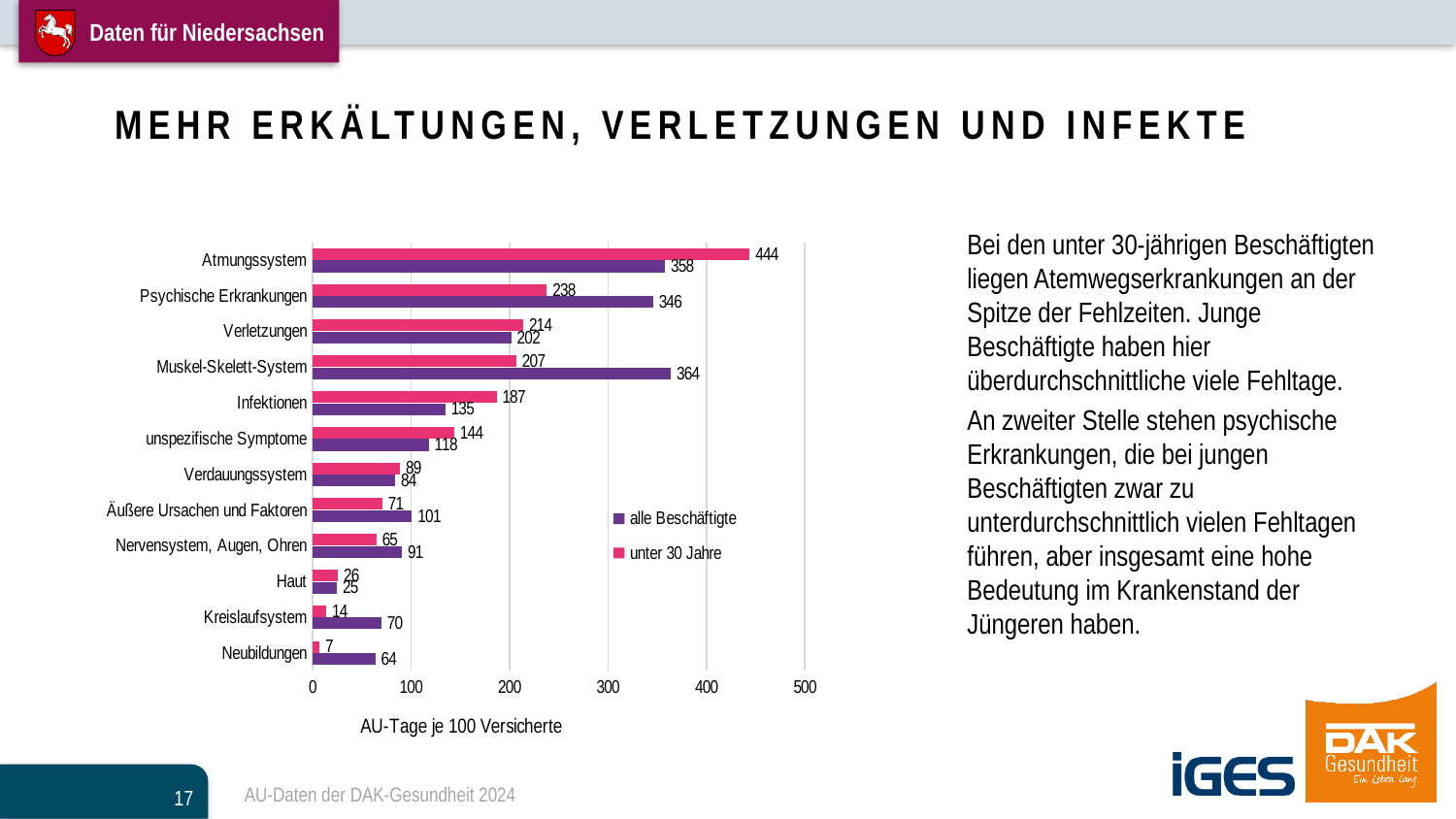
Which category has the lowest value for the "alle Beschäftigte" series? Neubildungen What value is shown for "unter 30 Jahre" in the Atmungssystem category? 444 Which category has the highest value for the "unter 30 Jahre" series? Atmungssystem What is the label of the horizontal axis of the chart? AU-Tage je 100 Versicherte What value is shown for "alle Beschäftigte" in the Muskel-Skelett-System category? 364 How many categories are shown on the chart? 12 How many series does the legend list? 2 What is the difference between the "unter 30 Jahre" and "alle Beschäftigte" values for Psychische Erkrankungen? 108 Is the "alle Beschäftigte" value for Atmungssystem greater or less than 300? greater For Infektionen, which series has the larger value: "alle Beschäftigte" or "unter 30 Jahre"? unter 30 Jahre What value is shown for "unter 30 Jahre" in the Kreislaufsystem category? 14 What type of chart is shown on the slide? Bar chart